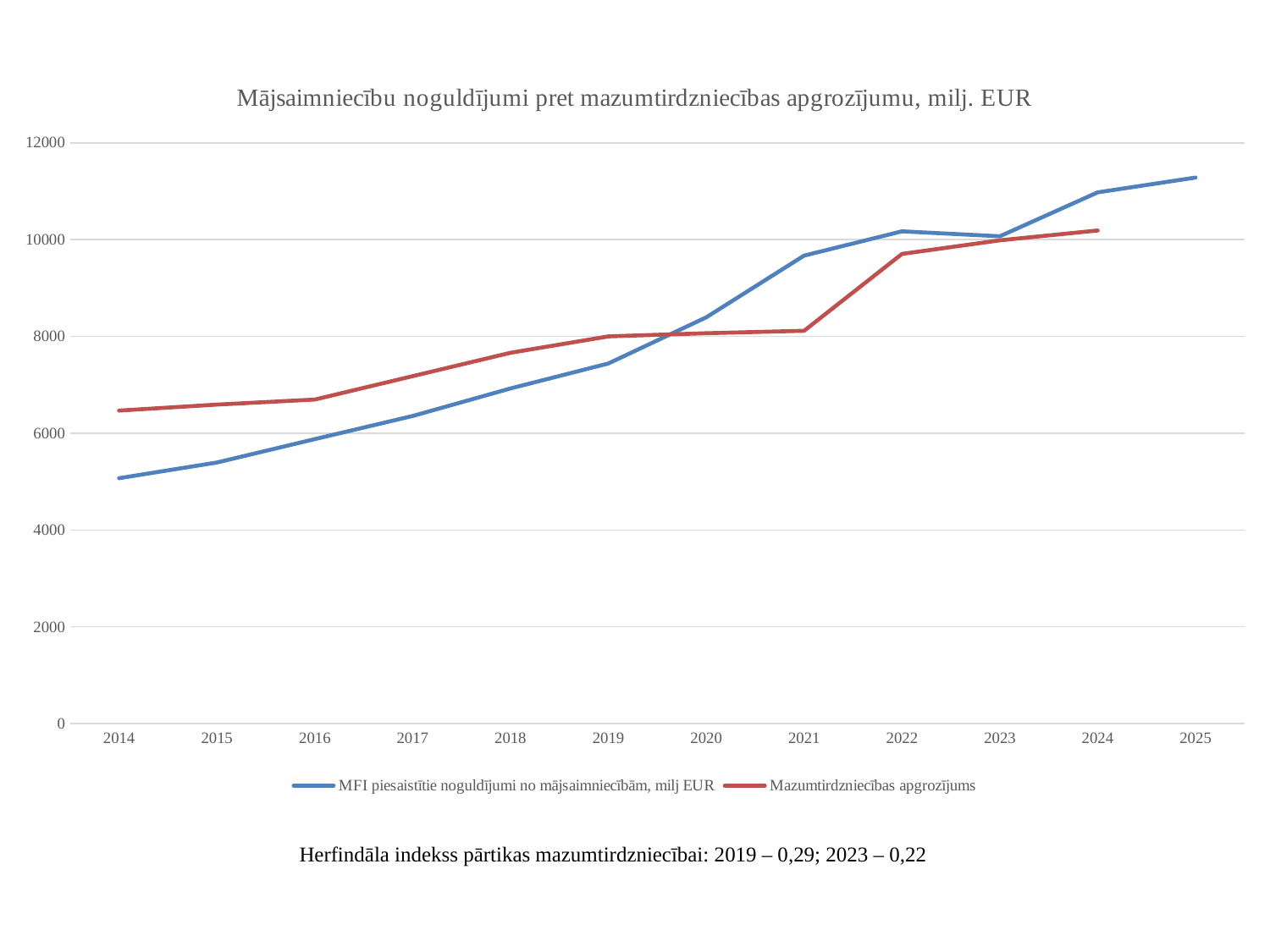
Does the MFI piesaistītie noguldījumi no mājsaimniecībām line rise or fall from 2014 to 2025? rise In 2021, which series has the larger value: MFI piesaistītie noguldījumi no mājsaimniecībām or Mazumtirdzniecības apgrozījums? MFI piesaistītie noguldījumi no mājsaimniecībām How many years are shown on the x axis? 12 In which year is the MFI piesaistītie noguldījumi no mājsaimniecībām series at its highest? 2025 What kind of chart is shown on the slide? line chart How many series does the legend list? 2 Is the value for MFI piesaistītie noguldījumi no mājsaimniecībām in 2019 greater or less than 8000? less Is the value for MFI piesaistītie noguldījumi no mājsaimniecībām in 2014 greater or less than 6000? less In 2014, which series has the larger value: MFI piesaistītie noguldījumi no mājsaimniecībām or Mazumtirdzniecības apgrozījums? Mazumtirdzniecības apgrozījums Is the value for MFI piesaistītie noguldījumi no mājsaimniecībām in 2025 greater or less than 10000? greater What is the title of the chart? Mājsaimniecību noguldījumi pret mazumtirdzniecības apgrozījumu, milj. EUR